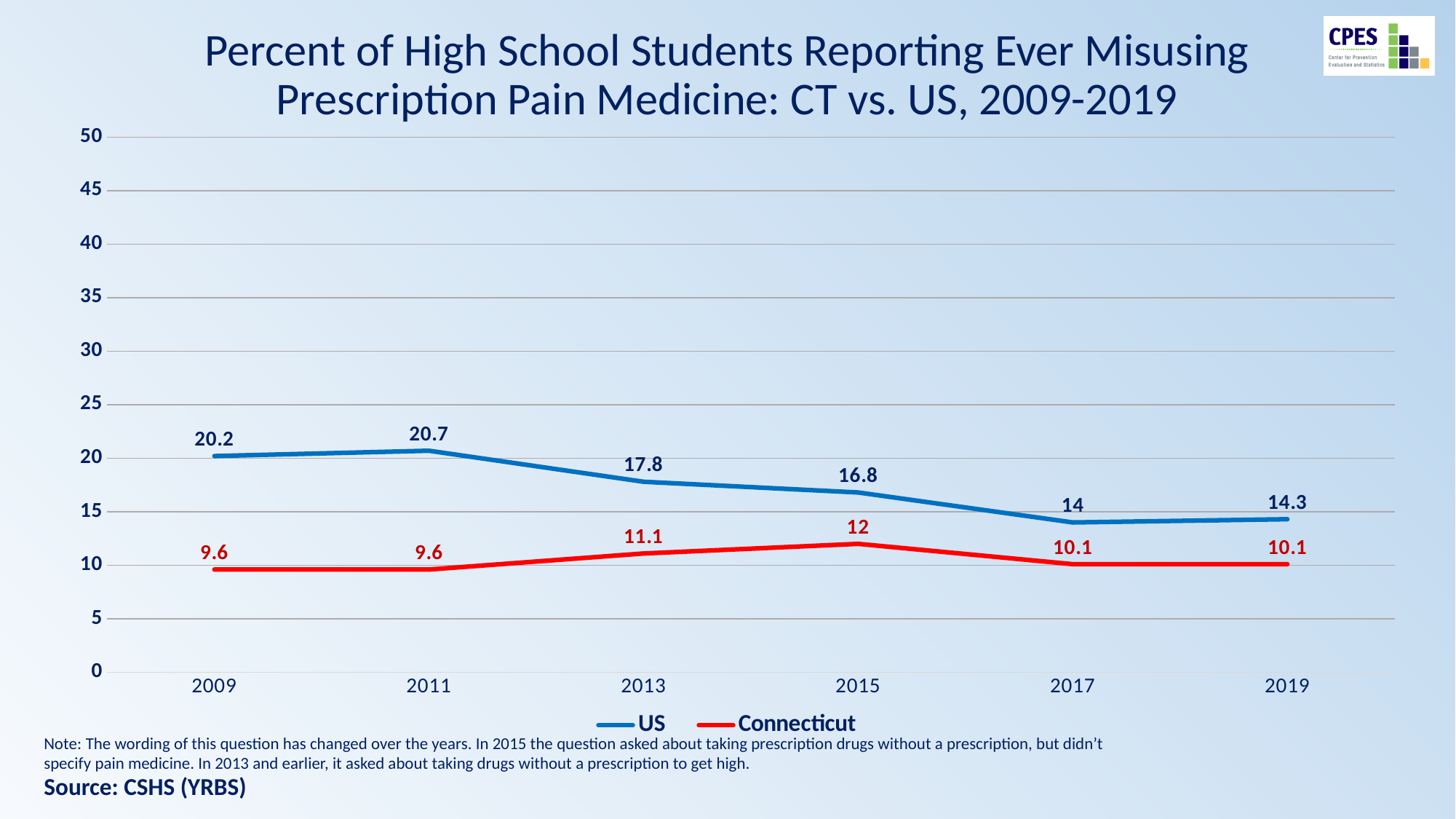
What is the US value in 2019? 14.3 What is the difference between the US and Connecticut values in 2009? 10.6 What is the US value in 2011? 20.7 In which year is the US series at its highest? 2011 How many series does the legend list? 2 What kind of chart is shown on the slide? Line chart In which year is the Connecticut series at its highest? 2015 Which series has the larger value in 2013, US or Connecticut? US Does the US series generally rise or fall from 2011 to 2017? Fall What is the Connecticut value in 2015? 12 In which year is the US series at its lowest? 2017 How many years are shown on the x axis? 6